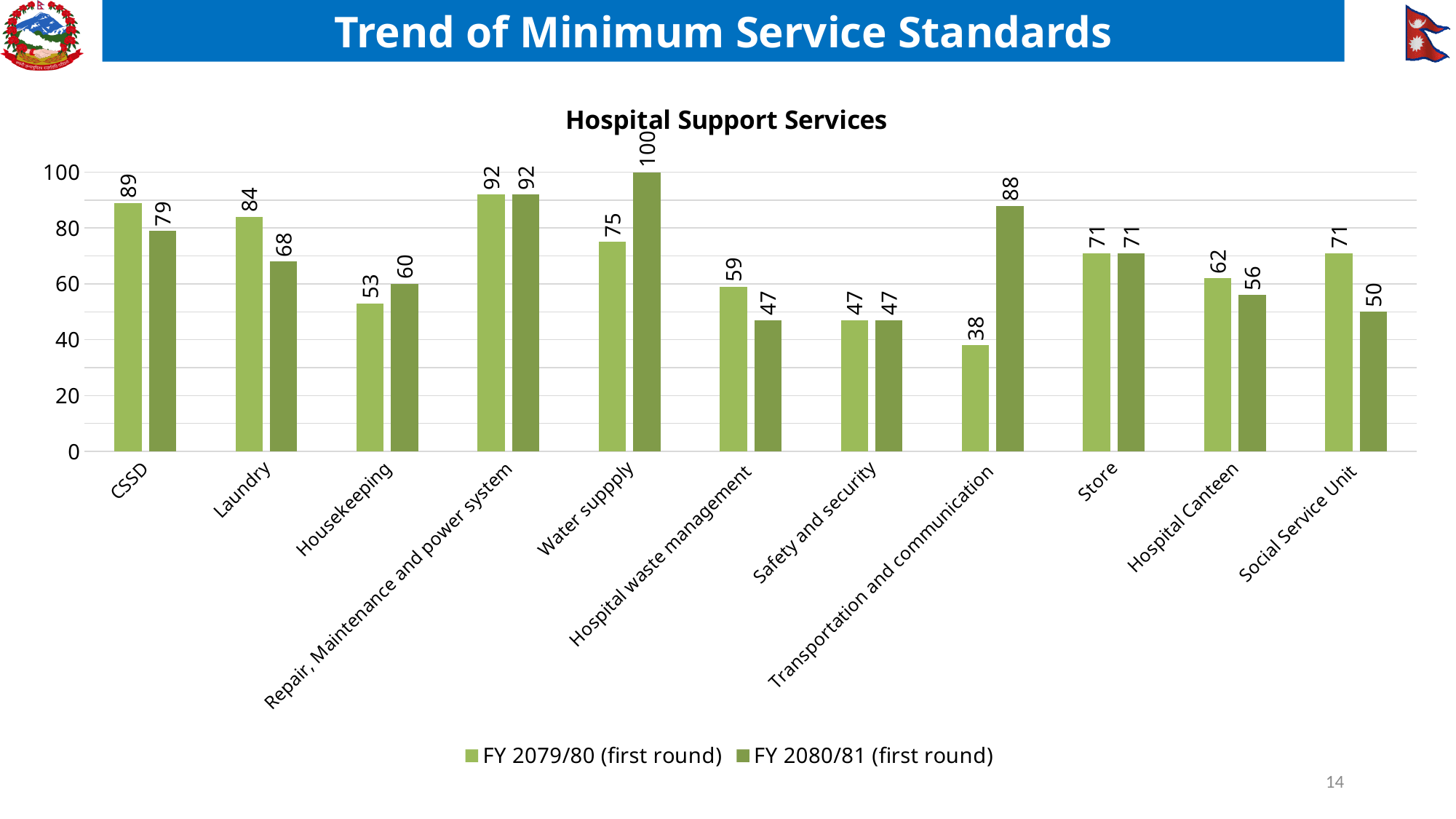
Which category has the highest value in FY 2080/81 (first round)? Water suppply What kind of chart is shown on the slide? Bar chart What is the title of the chart? Hospital Support Services How many series does the legend list? 2 What is the value for Transportation and communication in FY 2080/81 (first round)? 88 What is the value for Hospital Canteen in FY 2080/81 (first round)? 56 What is the difference between the FY 2079/80 (first round) and FY 2080/81 (first round) values for Social Service Unit? 21 Which is larger for Laundry: the FY 2079/80 (first round) value or the FY 2080/81 (first round) value? FY 2079/80 (first round) What is the difference between the FY 2080/81 (first round) and FY 2079/80 (first round) values for Transportation and communication? 50 How many categories are shown on the x axis? 11 Which category has the lowest value in FY 2079/80 (first round)? Transportation and communication What is the value for CSSD in FY 2079/80 (first round)? 89